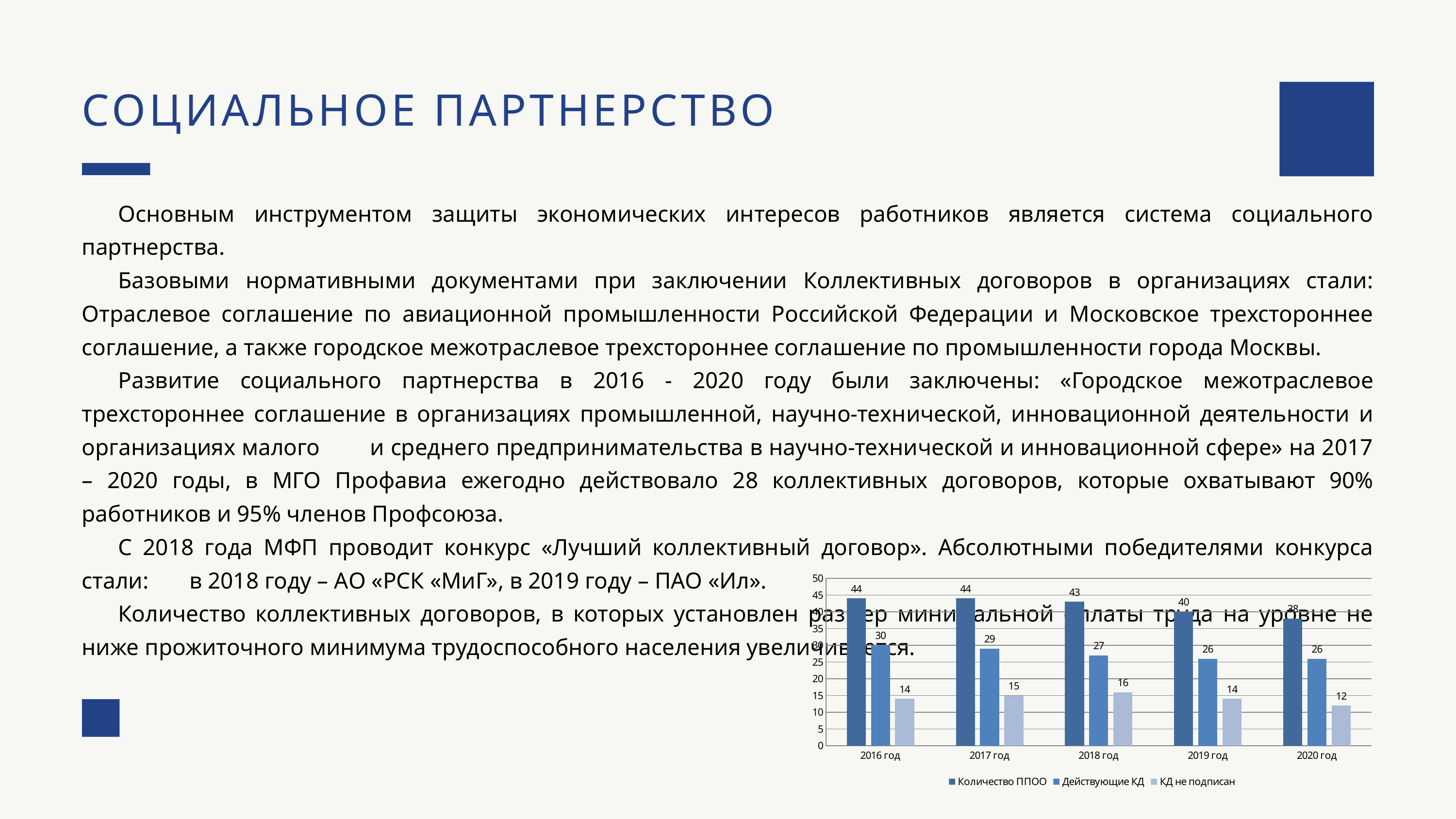
In which year is Количество ППОО lowest? 2020 год What is the value of КД не подписан for 2020 год? 12 How many series does the chart legend list? 3 What is the name of the third series in the chart legend? КД не подписан In which year is КД не подписан highest? 2018 год Which is larger: Действующие КД in 2017 год or Действующие КД in 2020 год? 2017 год What kind of chart is shown on the slide? bar chart What is the value of Действующие КД for 2016 год? 30 How many year categories are shown on the x axis of the chart? 5 What is the difference between Количество ППОО and Действующие КД in 2019 год? 14 What is the value of Количество ППОО for 2018 год? 43 Does Количество ППОО rise or fall from 2017 год to 2020 год? fall